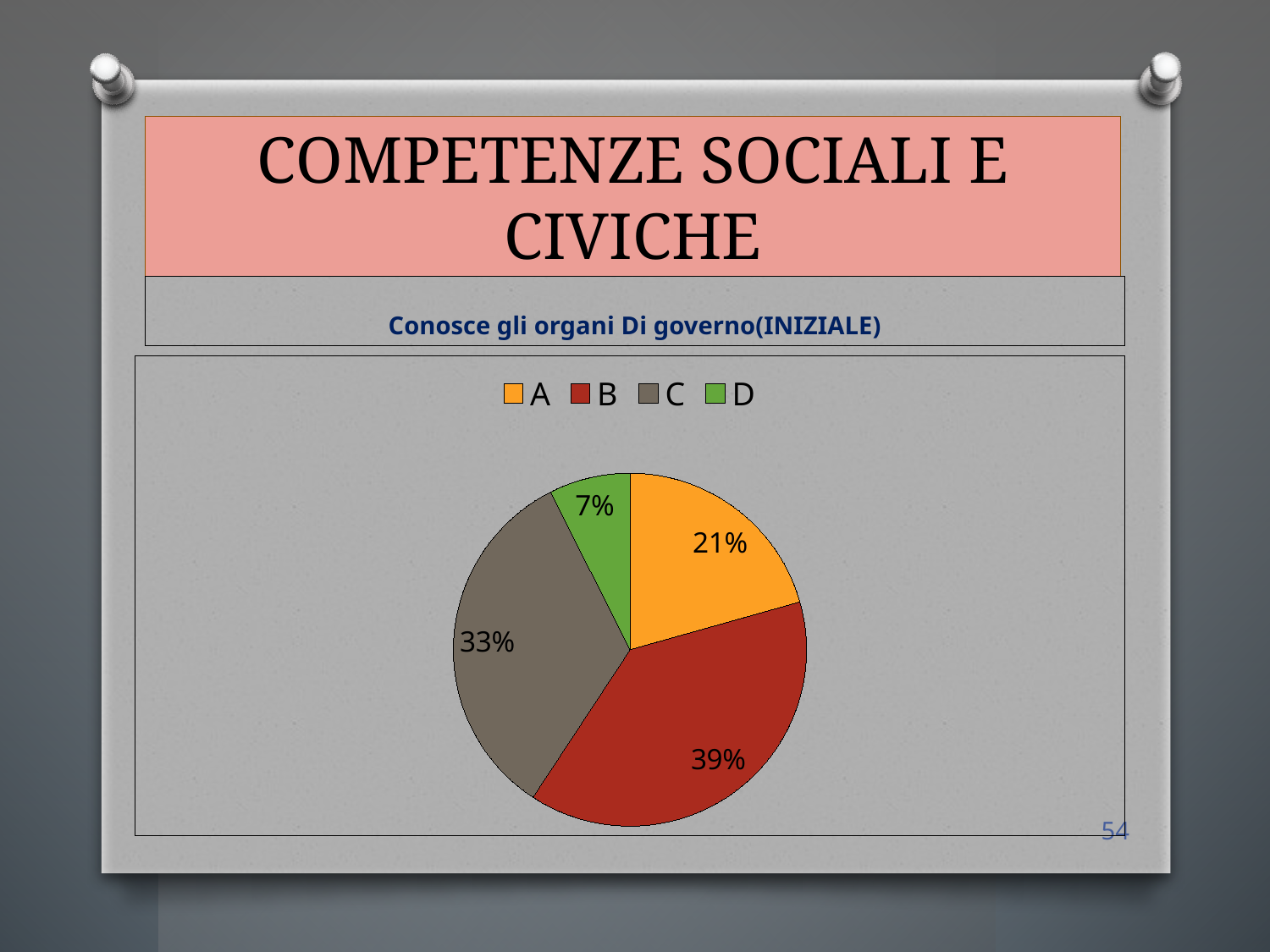
Which category has the largest slice of the pie? B What percentage of the pie does slice D represent? 7% How many entries does the legend list? 4 Which is larger, slice A or slice C? C What percentage of the pie does slice B represent? 39% Which category has the smallest slice of the pie? D What percentage of the pie does slice C represent? 33% What percentage of the pie does slice A represent? 21% What is the difference in percentage points between slice B and slice C? 6 What is the title shown above the pie chart? Conosce gli organi Di governo(INIZIALE) What type of chart is shown on the slide? pie chart How many slices does the pie chart have? 4